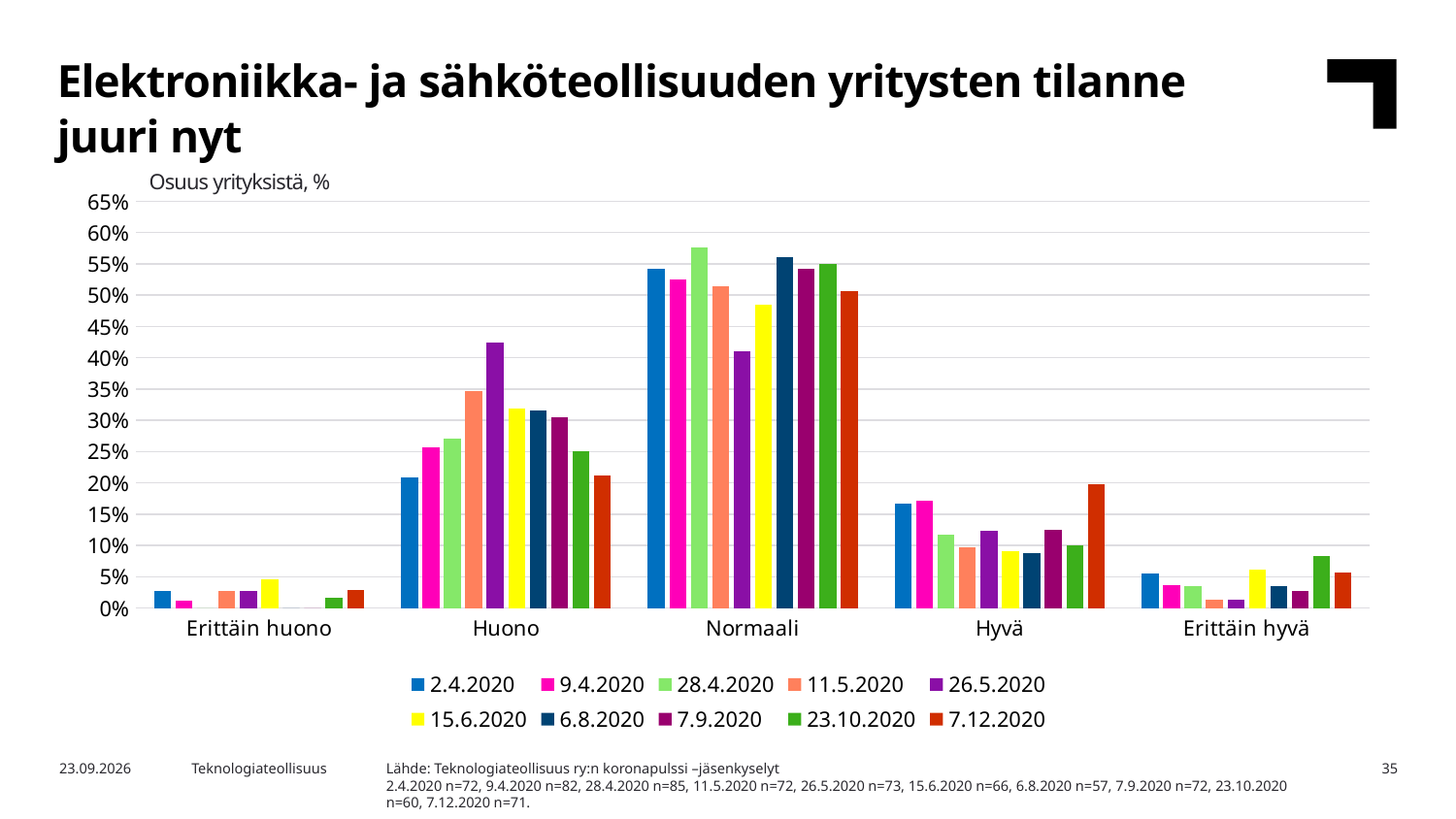
Which series has the lowest value in the Normaali category? 26.5.2020 Is the value for 7.12.2020 in the Hyvä category greater or less than 15%? greater What is the label shown above the vertical axis of the chart? Osuus yrityksistä, % Which series has the highest value in the Normaali category? 28.4.2020 Is the value for 28.4.2020 in the Normaali category greater or less than 55%? greater What kind of chart is shown on the slide? bar chart Which series has the highest value in the Huono category? 26.5.2020 Which series has the highest value in the Hyvä category? 7.12.2020 Is the value for 26.5.2020 in the Huono category greater or less than 40%? greater How many categories are shown on the x axis? 5 In the Hyvä category, which is larger: the value for 2.4.2020 or for 7.12.2020? 7.12.2020 How many series does the legend list? 10